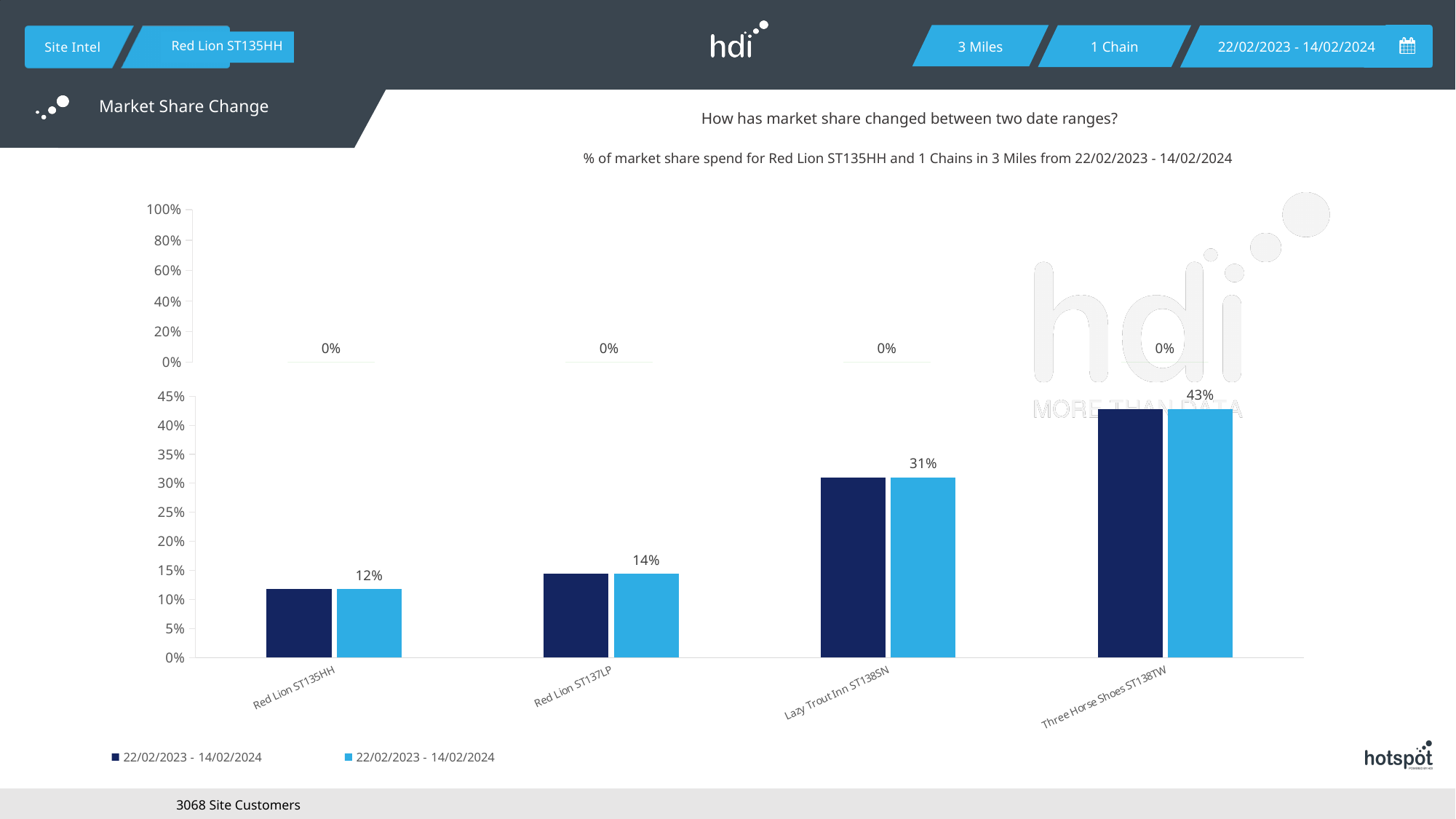
In the bottom chart, what is the market share value labelled for Lazy Trout Inn ST138SN? 31% In the bottom chart, what is the market share value labelled for Red Lion ST135HH? 12% In the bottom chart, which category has the highest market share? Three Horse Shoes ST138TW How many categories are shown on the x axis of the bottom chart? 4 In the bottom chart, is the value for Red Lion ST137LP greater or less than 20%? less What kind of chart is the bottom chart? bar chart In the top chart, what value is labelled for Red Lion ST137LP? 0% How many series does the legend of the bottom chart list? 2 In the bottom chart, which category has the lowest market share? Red Lion ST135HH In the bottom chart, which is larger: the value for Red Lion ST137LP or the value for Lazy Trout Inn ST138SN? Lazy Trout Inn ST138SN In the bottom chart, what is the difference between the labelled values for Three Horse Shoes ST138TW and Lazy Trout Inn ST138SN? 12% In the bottom chart, what is the market share value labelled for Three Horse Shoes ST138TW? 43%